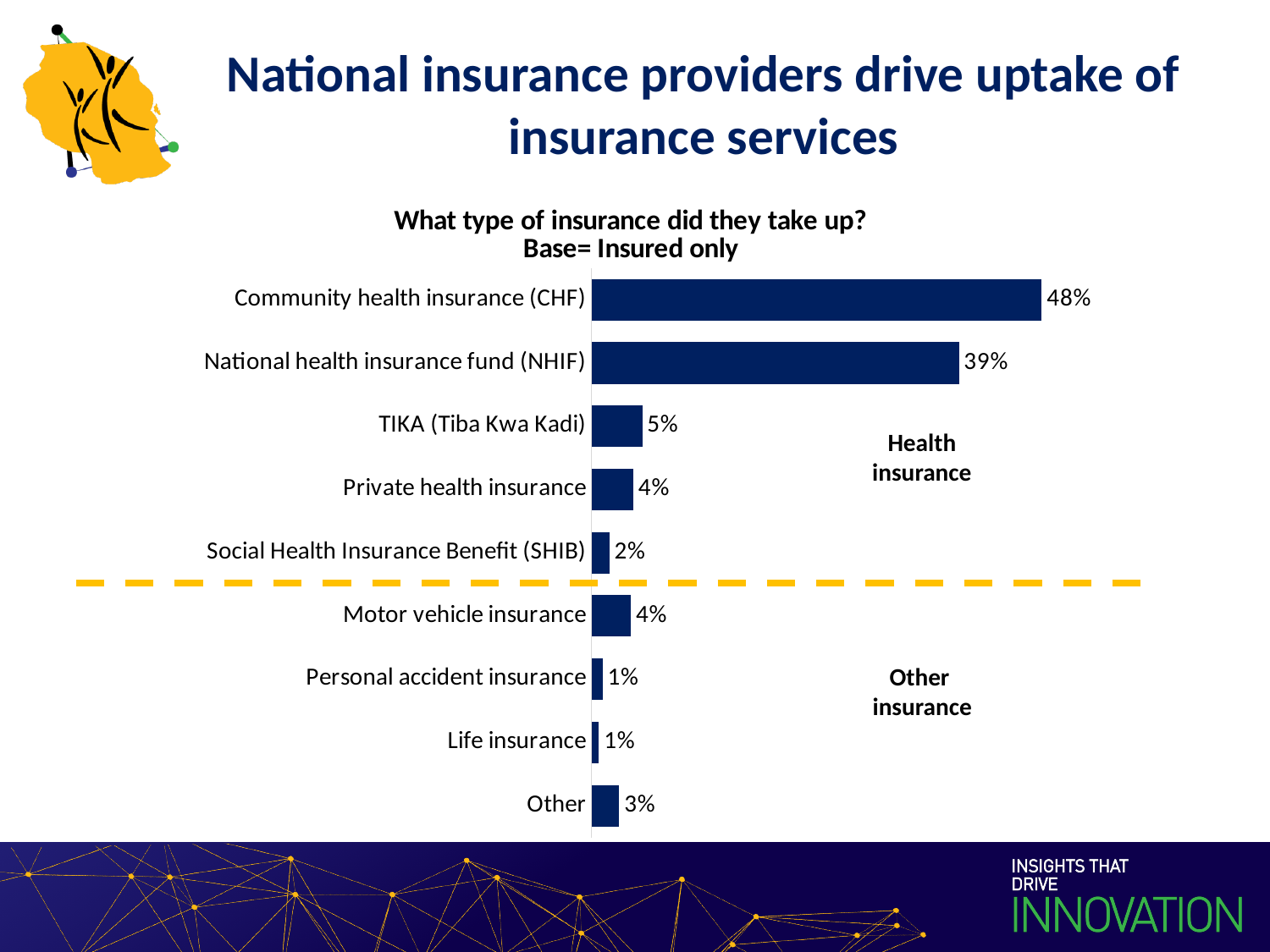
What kind of chart is shown on the slide? Bar chart What is the combined value of Personal accident insurance and Life insurance? 2% What is the difference between the values for Community health insurance (CHF) and National health insurance fund (NHIF)? 9 percentage points What percentage is shown for Motor vehicle insurance? 4% Which is larger, the value for TIKA (Tiba Kwa Kadi) or the value for Private health insurance? TIKA (Tiba Kwa Kadi) Which type of insurance has the highest uptake? Community health insurance (CHF) What is the value for Social Health Insurance Benefit (SHIB)? 2% What percentage of insured respondents took up Community health insurance (CHF)? 48% What is the value shown for National health insurance fund (NHIF)? 39% How many insurance types are listed in the chart? 9 What is the value shown for the Other category? 3% What is the base stated in the chart title? Insured only